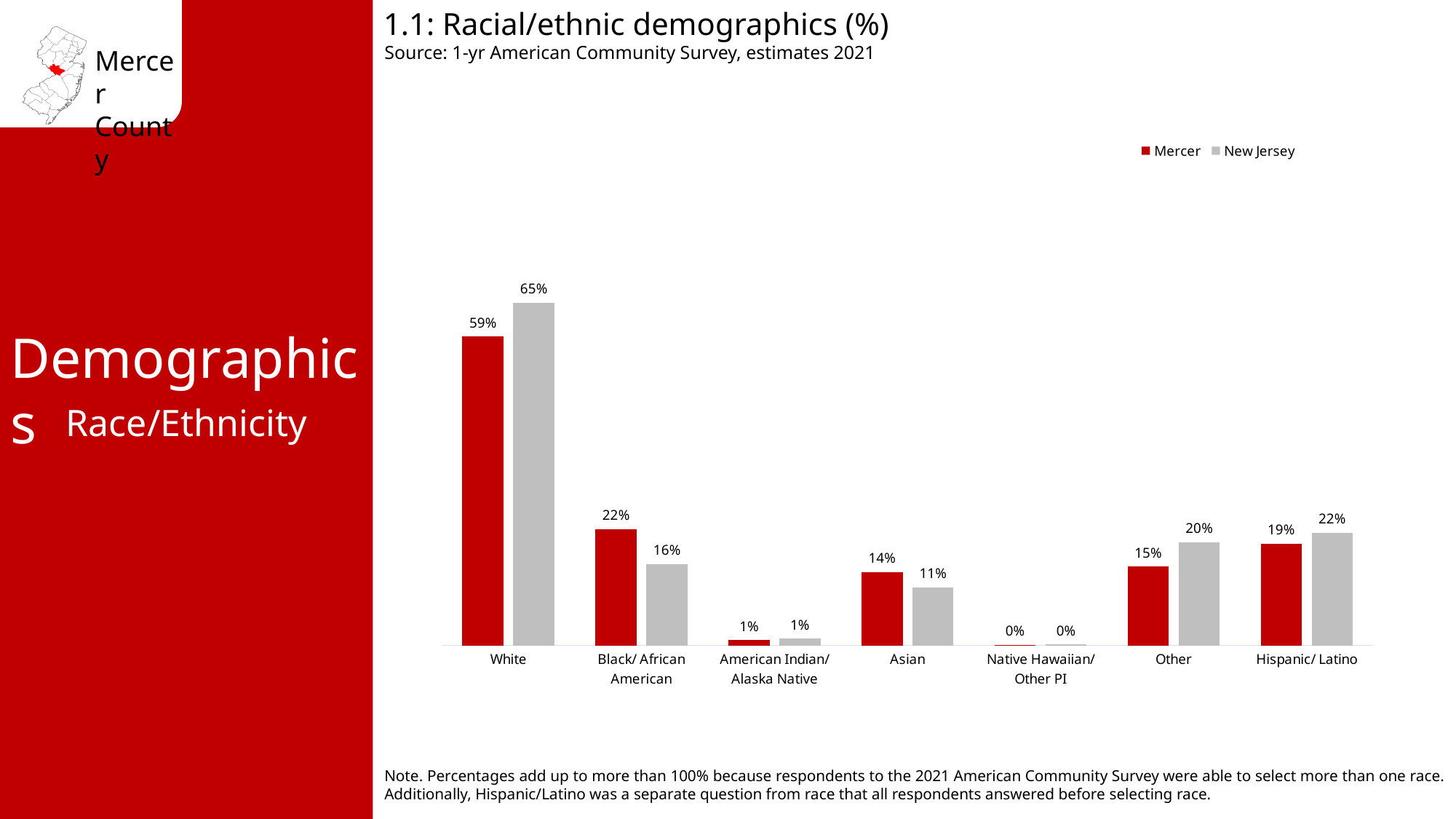
What kind of chart is shown? Bar chart Which is larger for Other, the Mercer value or the New Jersey value? New Jersey How many series does the legend list? 2 How many categories are shown on the x axis? 7 Which category has the lowest New Jersey value? Native Hawaiian/ Other PI What is the Mercer value for Asian? 14% What is the difference between the New Jersey and Mercer values for White? 6% Which is larger for Black/ African American, the Mercer value or the New Jersey value? Mercer What is the New Jersey value for Black/ African American? 16% Which category has the highest Mercer value? White What is the New Jersey value for Hispanic/ Latino? 22% What is the Mercer value for White? 59%